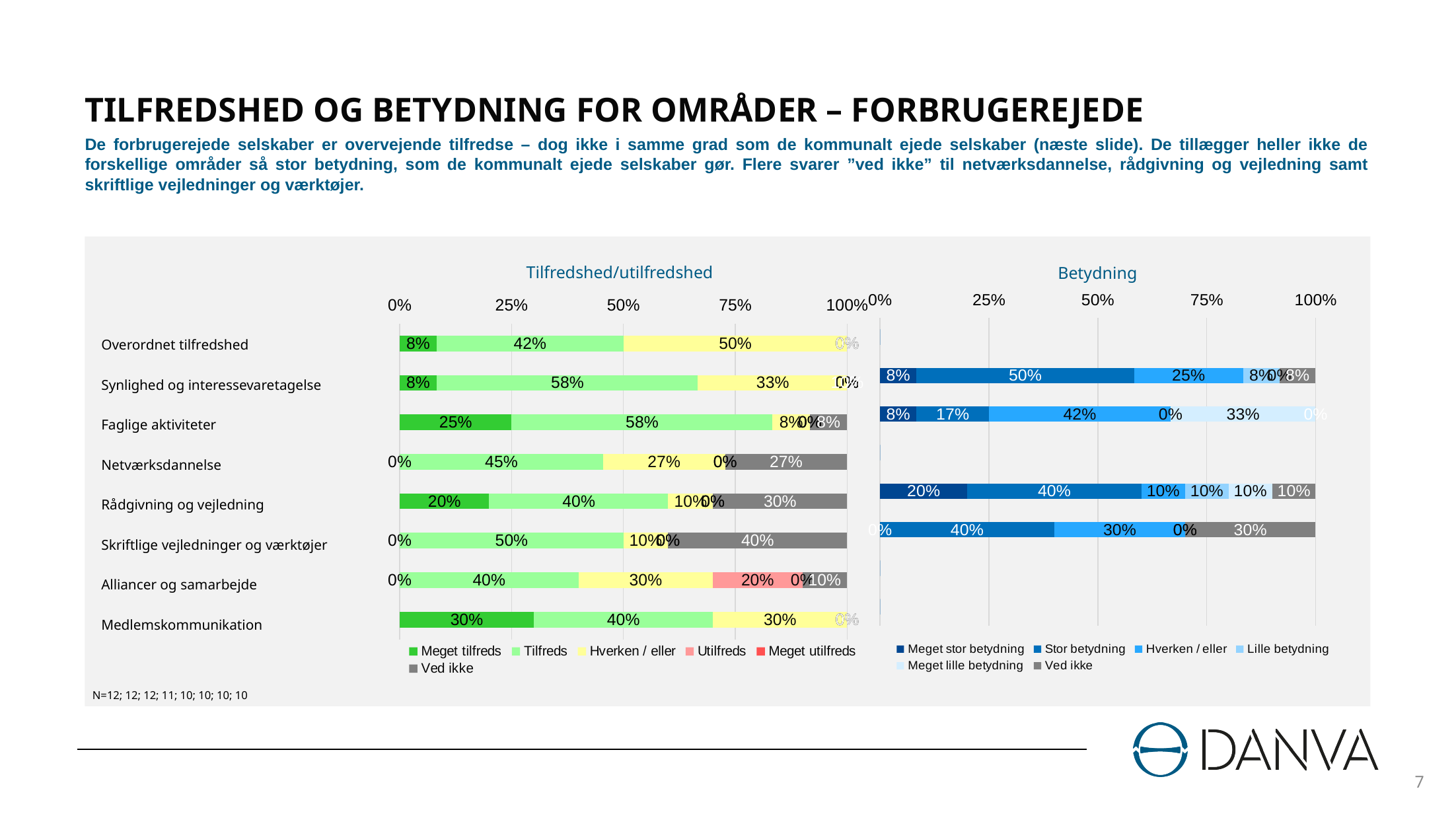
In the "Tilfredshed/utilfredshed" chart, which category has the highest "Meget tilfreds" value? Medlemskommunikation What kind of chart is the "Tilfredshed/utilfredshed" chart? Stacked bar chart In the "Tilfredshed/utilfredshed" chart, which has the larger "Ved ikke" value: Netværksdannelse or Rådgivning og vejledning? Rådgivning og vejledning In the "Tilfredshed/utilfredshed" chart, how much higher is the "Tilfreds" value for Faglige aktiviteter than for Overordnet tilfredshed? 16 percentage points In the "Tilfredshed/utilfredshed" chart, what is the "Utilfreds" value for Alliancer og samarbejde? 20% In the "Betydning" chart, what is the "Stor betydning" value for Synlighed og interessevaretagelse? 50% How many series does the legend of the "Betydning" chart list? 6 How many categories are shown on the "Tilfredshed/utilfredshed" chart? 8 In the "Tilfredshed/utilfredshed" chart, what is the "Tilfreds" value for Synlighed og interessevaretagelse? 58% How many series does the legend of the "Tilfredshed/utilfredshed" chart list? 6 In the "Betydning" chart, what is the "Hverken / eller" value for Faglige aktiviteter? 42% In the "Tilfredshed/utilfredshed" chart, what is the "Ved ikke" value for Skriftlige vejledninger og værktøjer? 40%